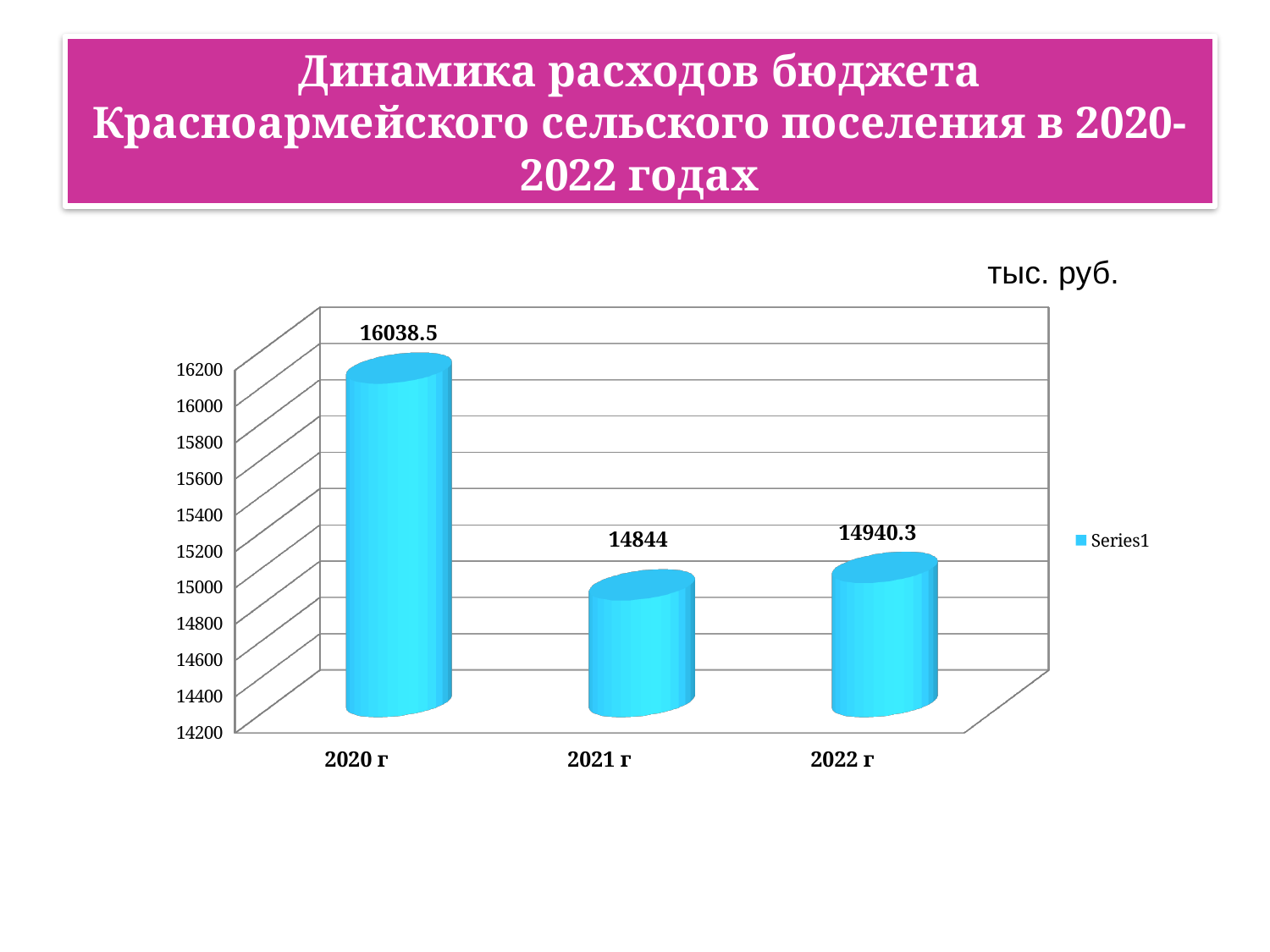
Which is larger, the value for 2020 г or the value for 2022 г? 2020 г Which year has the highest value? 2020 г What kind of chart is shown on the slide? bar chart What is the value for 2022 г? 14940.3 What is the difference between the values for 2020 г and 2021 г? 1194.5 Which year has the lowest value? 2021 г What is the value for 2020 г? 16038.5 How many categories are shown on the x axis? 3 What is the difference between the values for 2022 г and 2021 г? 96.3 What is the value for 2021 г? 14844 Is the value for 2021 г greater or less than 15000? less What unit is indicated above the chart? тыс. руб.